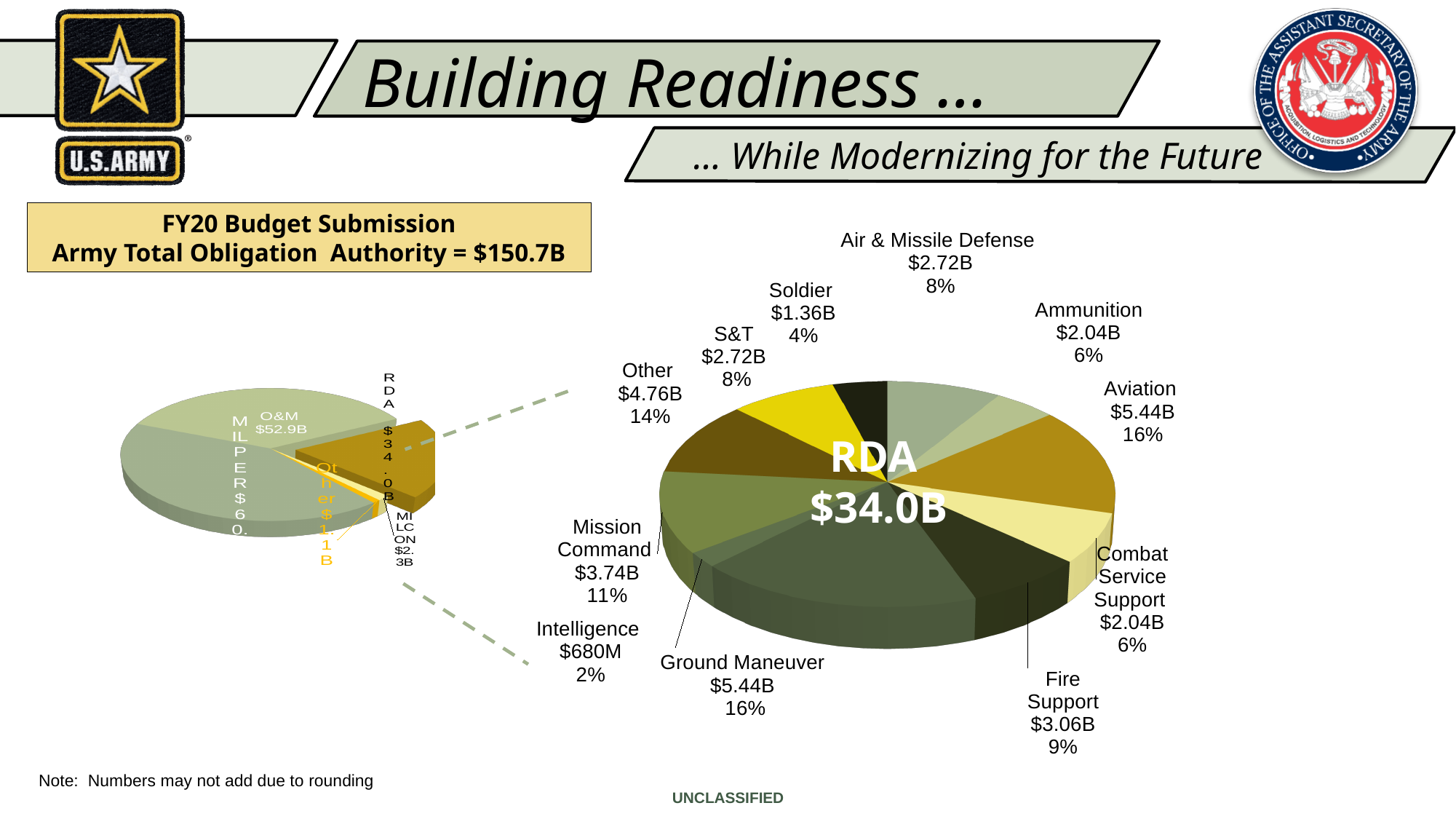
In the RDA $34.0B pie chart, what share of the pie does Air & Missile Defense represent? 8% In the RDA $34.0B pie chart, which category has the smallest slice? Intelligence In the RDA $34.0B pie chart, which is larger, Fire Support or Ammunition? Fire Support In the small pie chart on the left, what is the value for O&M? $52.9B In the RDA $34.0B pie chart, what is the difference between the Other value and the Soldier value? $3.40B What total is printed in the centre of the large pie chart on the right? RDA $34.0B In the RDA $34.0B pie chart, what share of the pie does Mission Command represent? 11% In the RDA $34.0B pie chart, what is the value for Aviation? $5.44B In the small pie chart on the left, which is larger, O&M or RDA? O&M In the RDA $34.0B pie chart, what is the value for Intelligence? $680M What kind of chart is the large chart on the right of the slide? Pie chart In the RDA $34.0B pie chart, how many categories are shown? 11